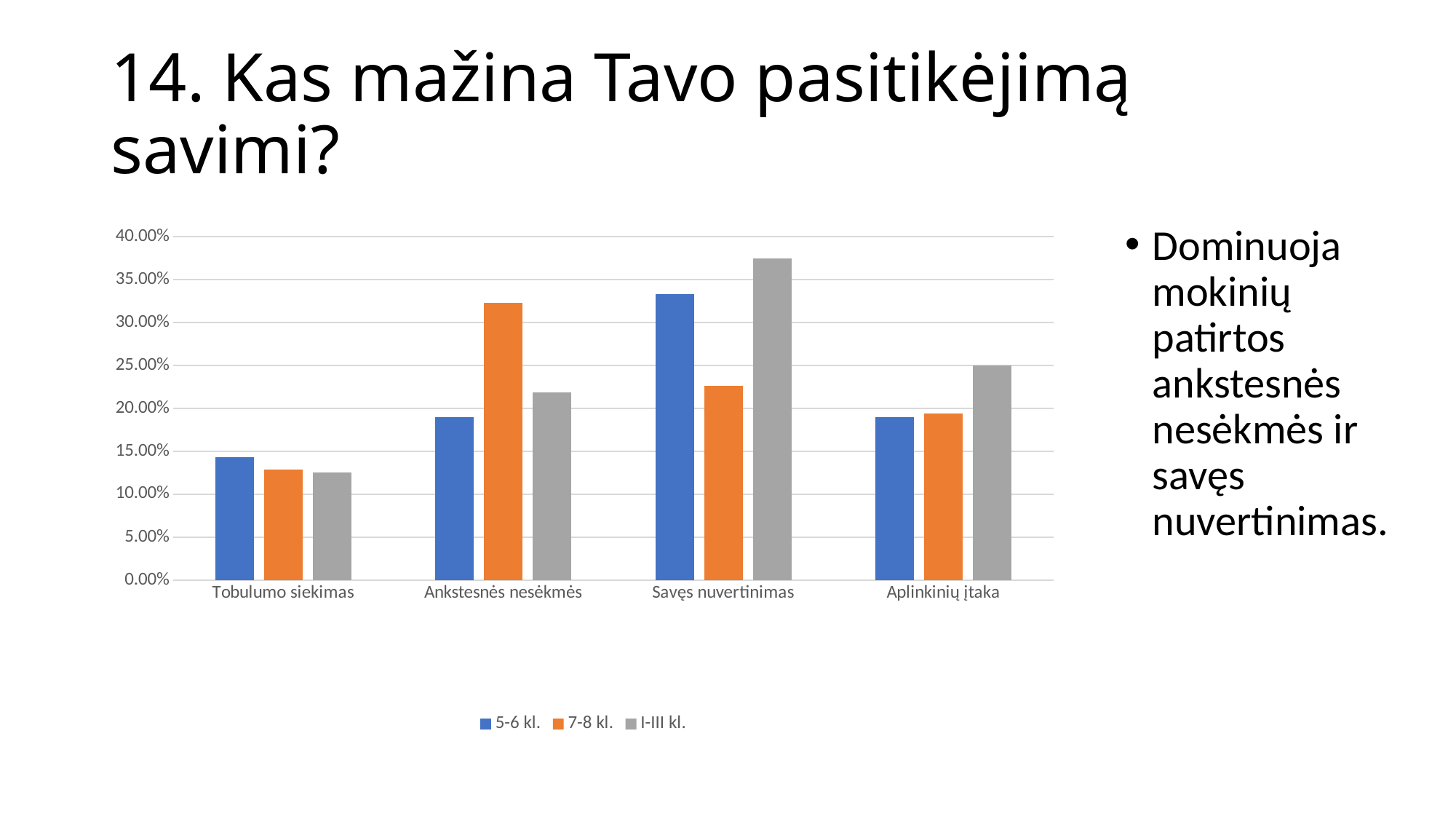
How many series does the chart's legend list? 3 Which series has the highest value for Aplinkinių įtaka? I-III kl. For the 5-6 kl. series, which is larger: Savęs nuvertinimas or Tobulumo siekimas? Savęs nuvertinimas Which series has the lowest value for Savęs nuvertinimas? 7-8 kl. How many categories are shown on the x axis of the chart? 4 Which series has the highest value for Ankstesnės nesėkmės? 7-8 kl. Is the value for 5-6 kl. in Tobulumo siekimas greater or less than 15.00%? less Is the value for I-III kl. in Savęs nuvertinimas greater or less than 35.00%? greater Which series are listed in the chart's legend? 5-6 kl., 7-8 kl., I-III kl. Is the value for 7-8 kl. in Ankstesnės nesėkmės greater or less than 30.00%? greater Which category has the tallest bar in the chart? Savęs nuvertinimas What kind of chart is shown on the slide? bar chart